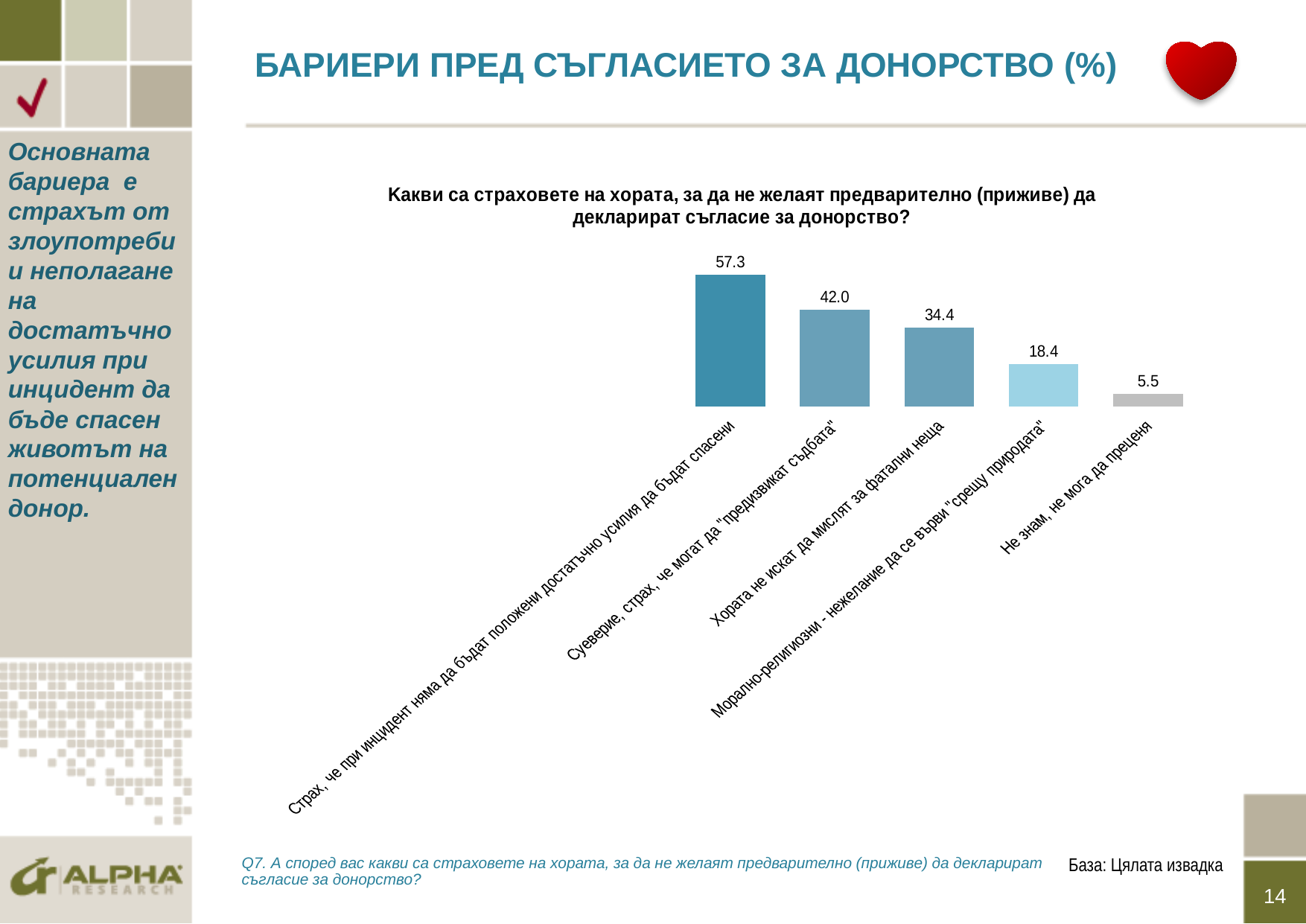
How many categories are shown in the chart? 5 What is the value for "Хората не искат да мислят за фатални неща"? 34.4 What is the value for "Не знам, не мога да преценя"? 5.5 What is the difference between "Хората не искат да мислят за фатални неща" and "Морално-религиозни - нежелание да се върви "срещу природата""? 16.0 Do the values rise or fall from left to right along the x axis? Fall Which category has the lowest value? Не знам, не мога да преценя Which category has the highest value? Страх, че при инцидент няма да бъдат положени достатъчно усилия да бъдат спасени What is the difference between the highest bar (57.3) and the bar for "Суеверие, страх, че могат да "предизвикат съдбата"" (42.0)? 15.3 Which is larger: the value for "Хората не искат да мислят за фатални неща" or the value for "Морално-религиозни - нежелание да се върви "срещу природата""? Хората не искат да мислят за фатални неща What type of chart is shown on the slide? Bar chart What is the value for "Суеверие, страх, че могат да "предизвикат съдбата""? 42.0 What is the value for "Морално-религиозни - нежелание да се върви "срещу природата""? 18.4